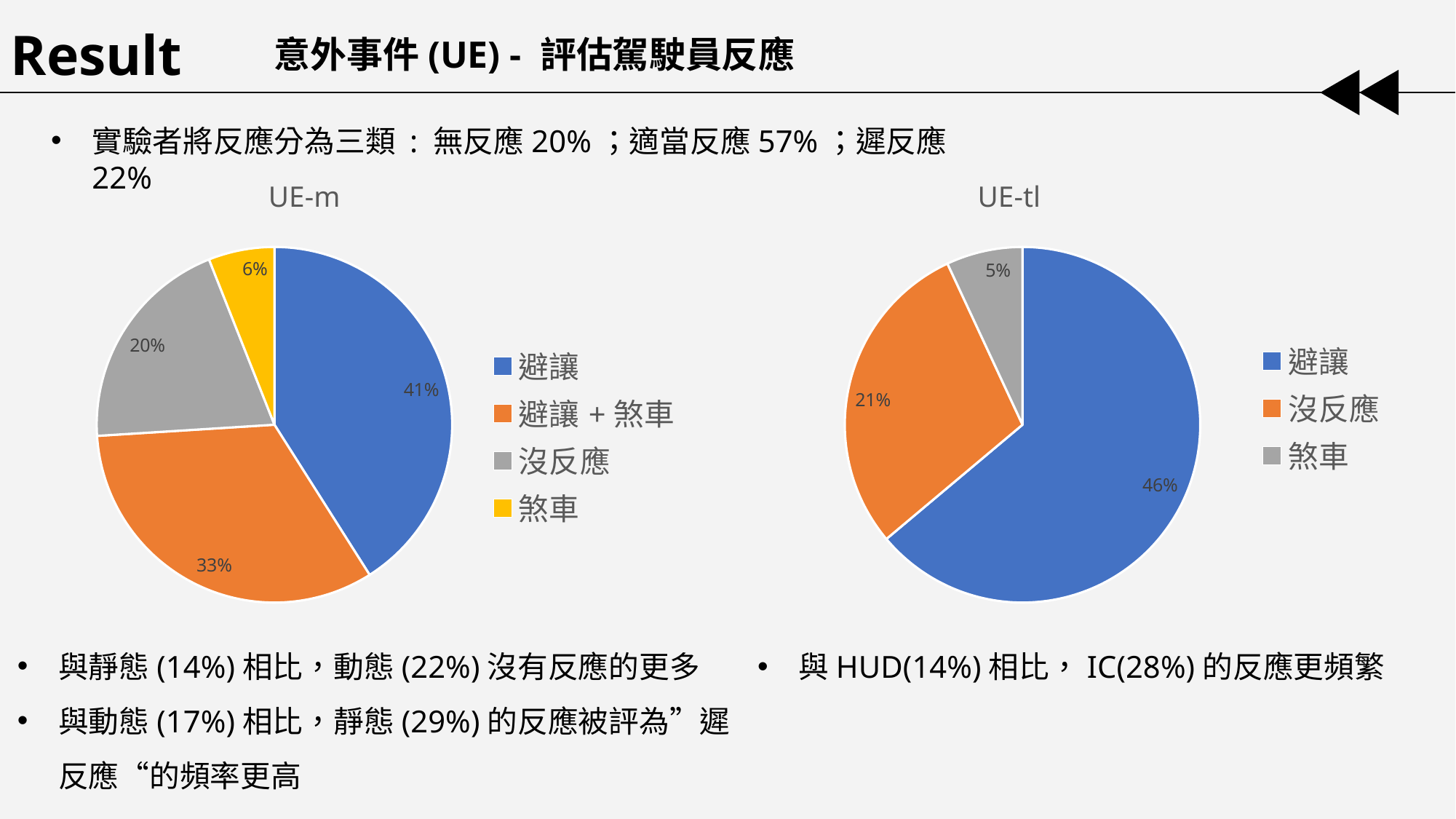
In the UE-tl chart, what share does 沒反應 have? 21% In the UE-m chart, what share does 避讓 + 煞車 have? 33% In the UE-m chart, which category has the largest slice? 避讓 How many categories does the UE-m chart's legend list? 4 What kind of chart is the UE-tl chart? Pie chart In the UE-m chart, what share does 煞車 have? 6% In the UE-tl chart, what is the difference between the 避讓 share and the 沒反應 share? 25% In the UE-tl chart, which category has the largest slice? 避讓 In the UE-tl chart, what share does 煞車 have? 5% In the UE-m chart, what share does 避讓 have? 41% In the UE-m chart, which category has the smallest slice? 煞車 In the UE-m chart, which is larger, 沒反應 or 避讓 + 煞車? 避讓 + 煞車